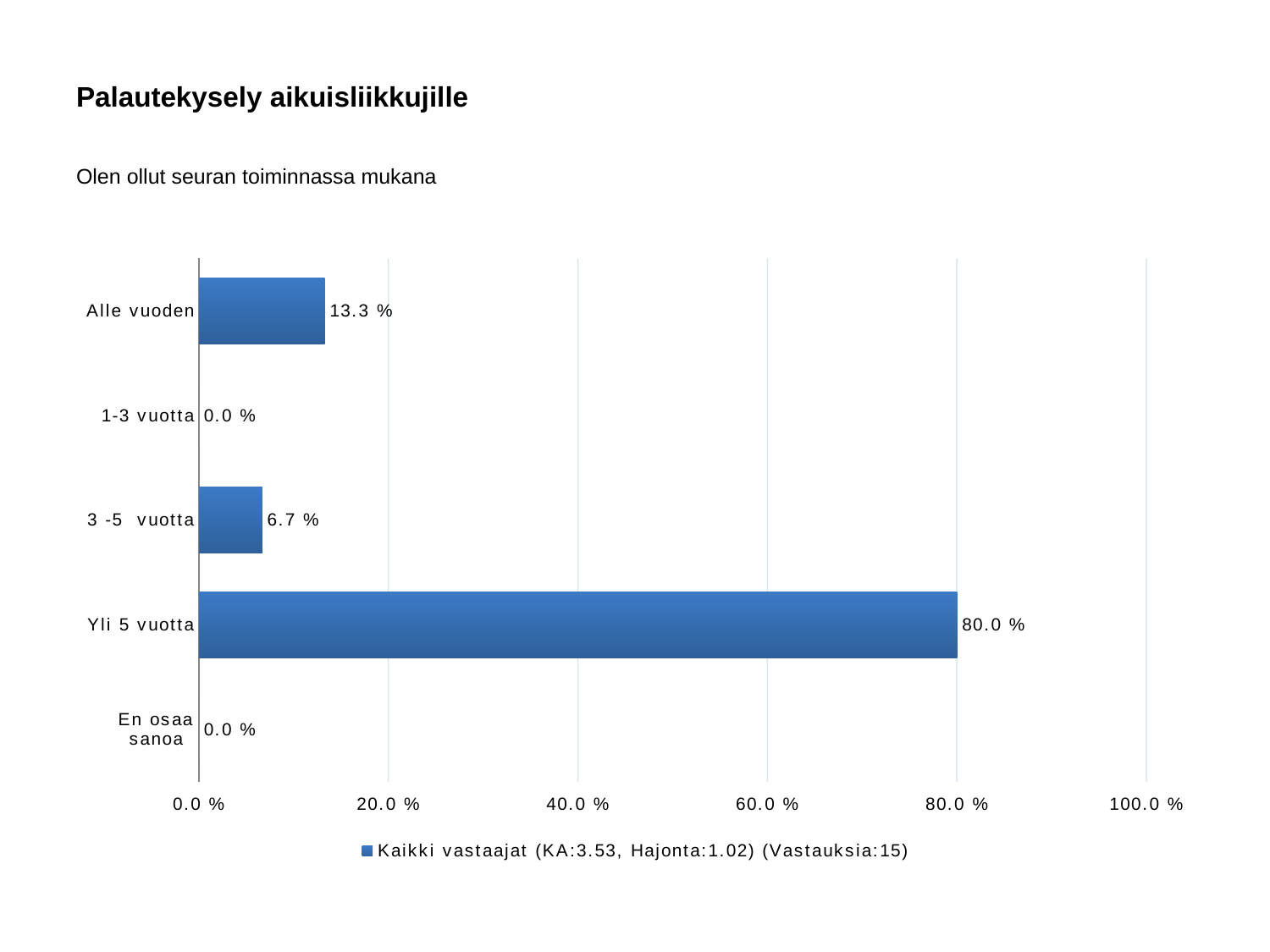
How many responses (Vastauksia) does the legend report? 15 Is the value for "Yli 5 vuotta" greater or less than 60.0 %? greater Which category has the highest value? Yli 5 vuotta What kind of chart is shown on the slide? bar chart What is the difference between the values for "Yli 5 vuotta" and "Alle vuoden"? 66.7 % What is the value for "Yli 5 vuotta"? 80.0 % What is the difference between the values for "Alle vuoden" and "3 -5 vuotta"? 6.6 % How many categories are shown on the chart? 5 Which is larger, the value for "Alle vuoden" or the value for "3 -5 vuotta"? Alle vuoden What is the value for "3 -5 vuotta"? 6.7 % What is the value for "1-3 vuotta"? 0.0 % What is the value for "Alle vuoden"? 13.3 %